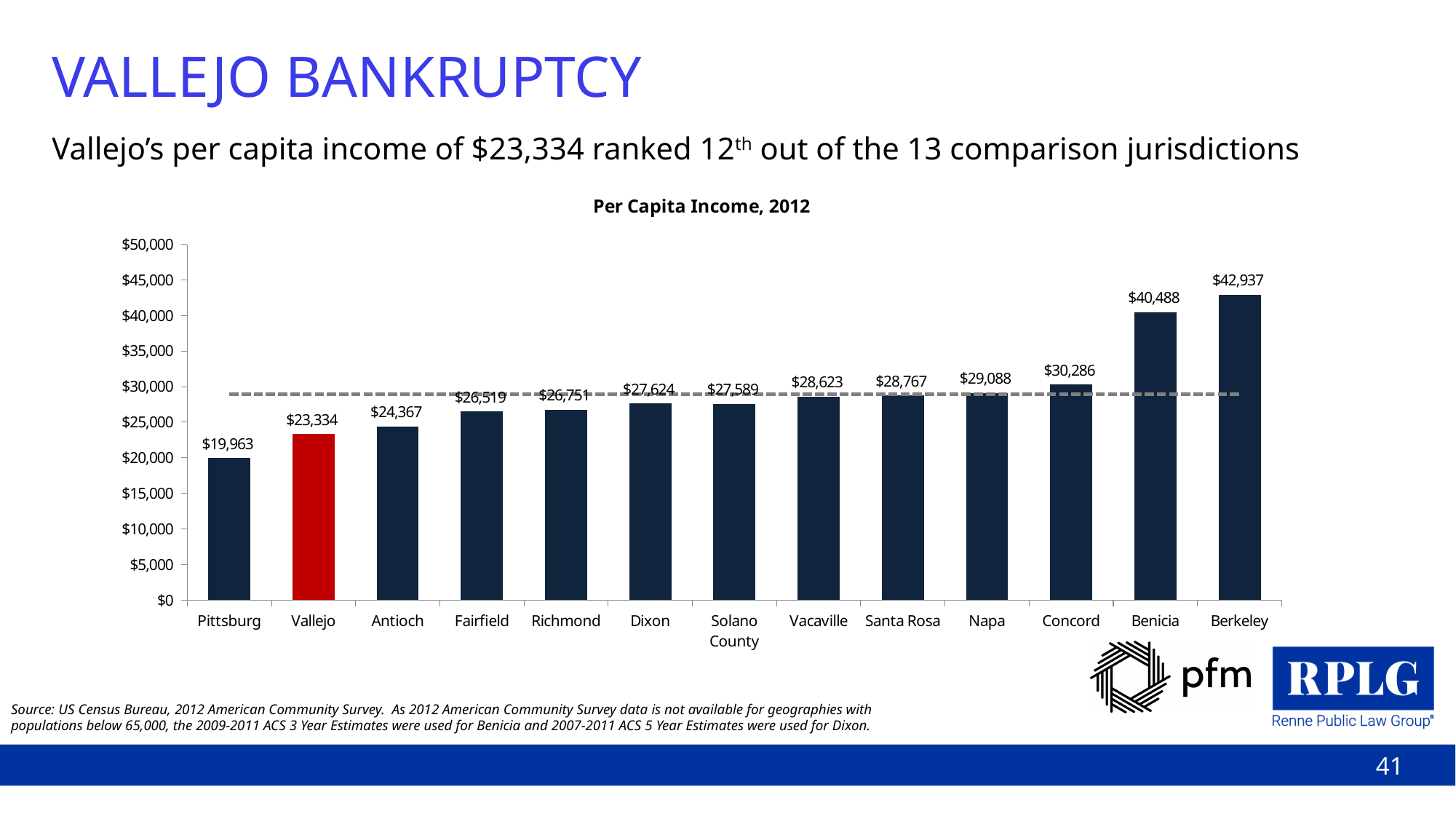
What is the per capita income shown for Vallejo? $23,334 What is the difference between Vallejo's and Pittsburg's per capita income? $3,371 Which has a higher per capita income, Concord or Napa? Concord Which jurisdiction has the highest per capita income in the chart? Berkeley How many jurisdictions are shown in the chart? 13 What is the per capita income shown for Benicia? $40,488 What type of chart is shown on the slide? bar chart What is the title of the chart? Per Capita Income, 2012 What is the per capita income shown for Solano County? $27,589 What is the difference between Berkeley's and Vallejo's per capita income? $19,603 Which jurisdiction has the lowest per capita income in the chart? Pittsburg Is the per capita income for Antioch greater or less than $25,000? less